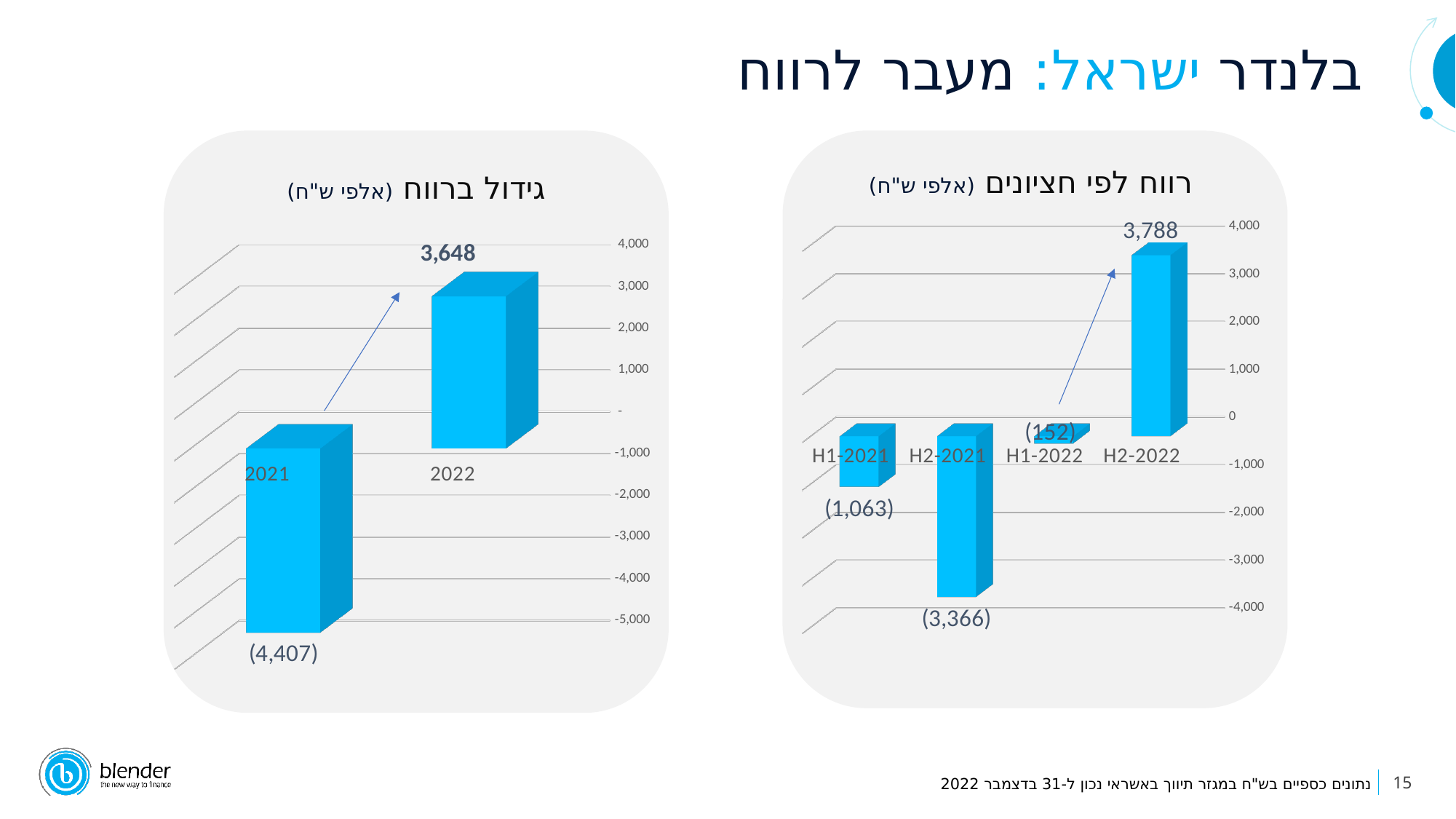
In the right chart (רווח לפי חציונים), what is the value shown for H2-2022? 3,788 What type of chart is the right chart (רווח לפי חציונים)? Bar chart In the left chart (גידול ברווח), what is the value shown for 2022? 3,648 In the right chart (רווח לפי חציונים), is the value for H1-2021 greater or less than -2,000? greater In the right chart (רווח לפי חציונים), what is the value shown for H1-2022? (152) In the right chart (רווח לפי חציונים), which half-year has the lowest value? H2-2021 In the left chart (גידול ברווח), what is the value shown for 2021? (4,407) In the right chart (רווח לפי חציונים), which half-year has the highest value? H2-2022 In the right chart (רווח לפי חציונים), what is the value shown for H2-2021? (3,366) In the left chart (גידול ברווח), how many categories are plotted? 2 In the right chart (רווח לפי חציונים), how many half-year categories are plotted? 4 In the left chart (גידול ברווח), which year has the larger value, 2021 or 2022? 2022